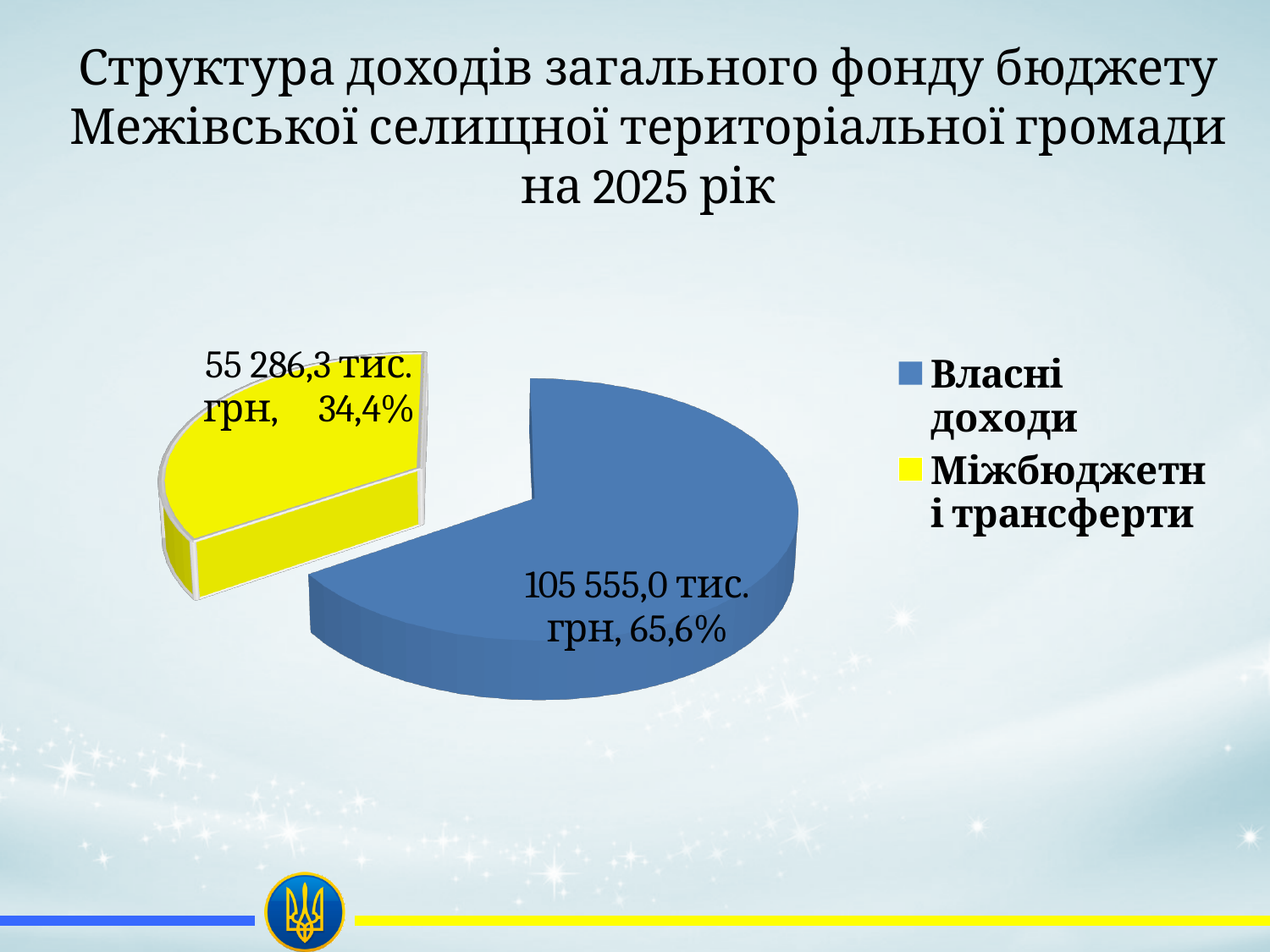
What colour is the slice for Міжбюджетні трансферти? Yellow What type of chart is shown on the slide? Pie chart What share of the pie does Міжбюджетні трансферти represent? 34,4% Which category has the largest slice of the pie? Власні доходи What is the value for Міжбюджетні трансферти? 55 286,3 тис. грн Which is larger, Власні доходи or Міжбюджетні трансферти? Власні доходи Which category has the smallest slice of the pie? Міжбюджетні трансферти What is the difference in value between Власні доходи and Міжбюджетні трансферти? 50 268,7 тис. грн What is the value for Власні доходи? 105 555,0 тис. грн What share of the pie does Власні доходи represent? 65,6% What is the total of the two slices in the pie chart? 160 841,3 тис. грн How many categories are shown in the pie chart? 2